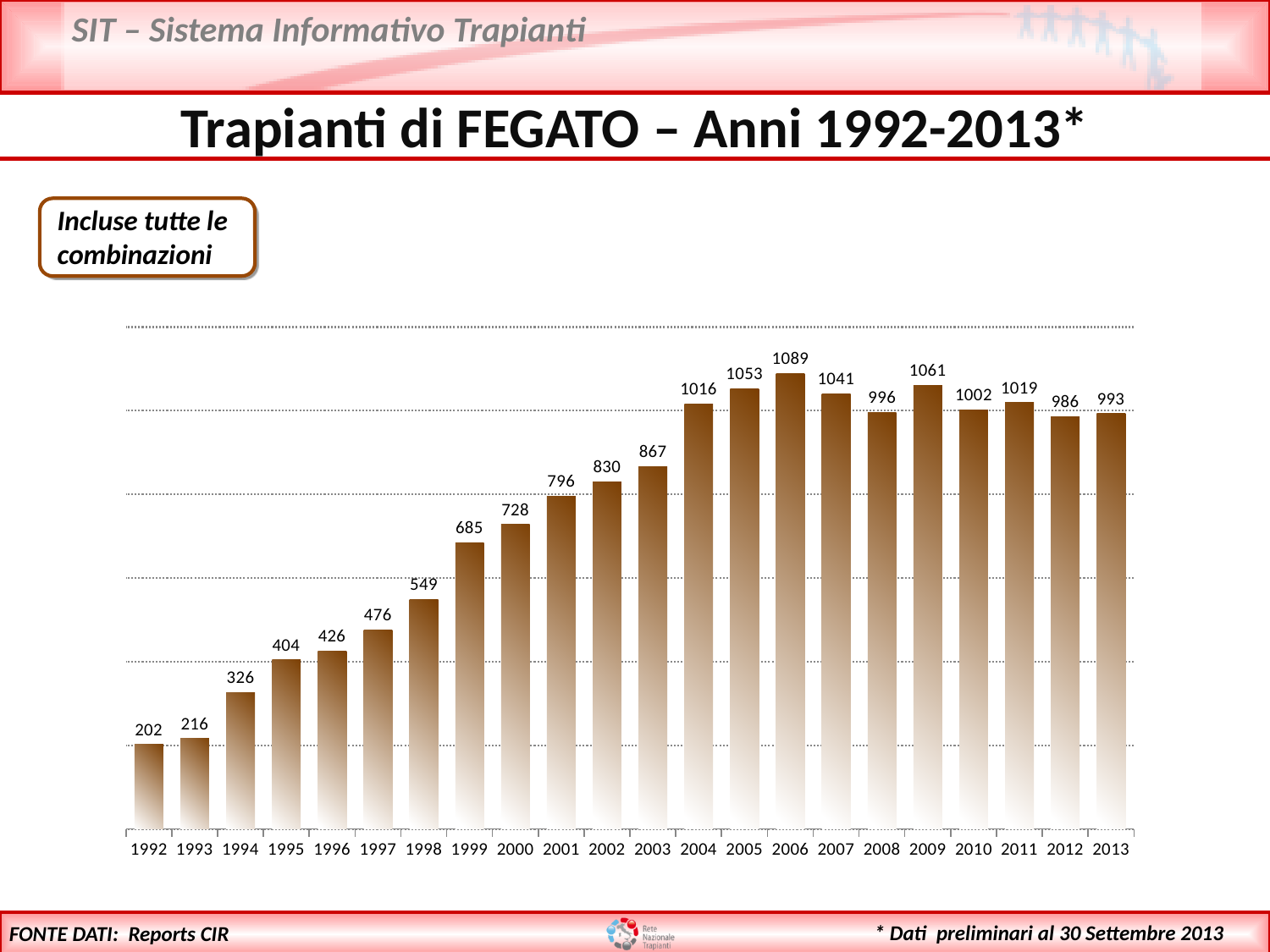
Do the values generally rise or fall from 1992 to 2006? rise Which is larger, the value for 2004 or the value for 2003? 2004 What is the difference between the values for 2009 and 2008? 65 Which year has the lowest value? 1992 What is the value for 2013? 993 What is the value for 2006? 1089 What is the title of the slide containing the chart? Trapianti di FEGATO – Anni 1992-2013* What kind of chart is this? bar chart Which year has the highest value? 2006 How many years are shown on the x axis? 22 What is the difference between the values for 2006 and 1992? 887 What is the value for 1992? 202